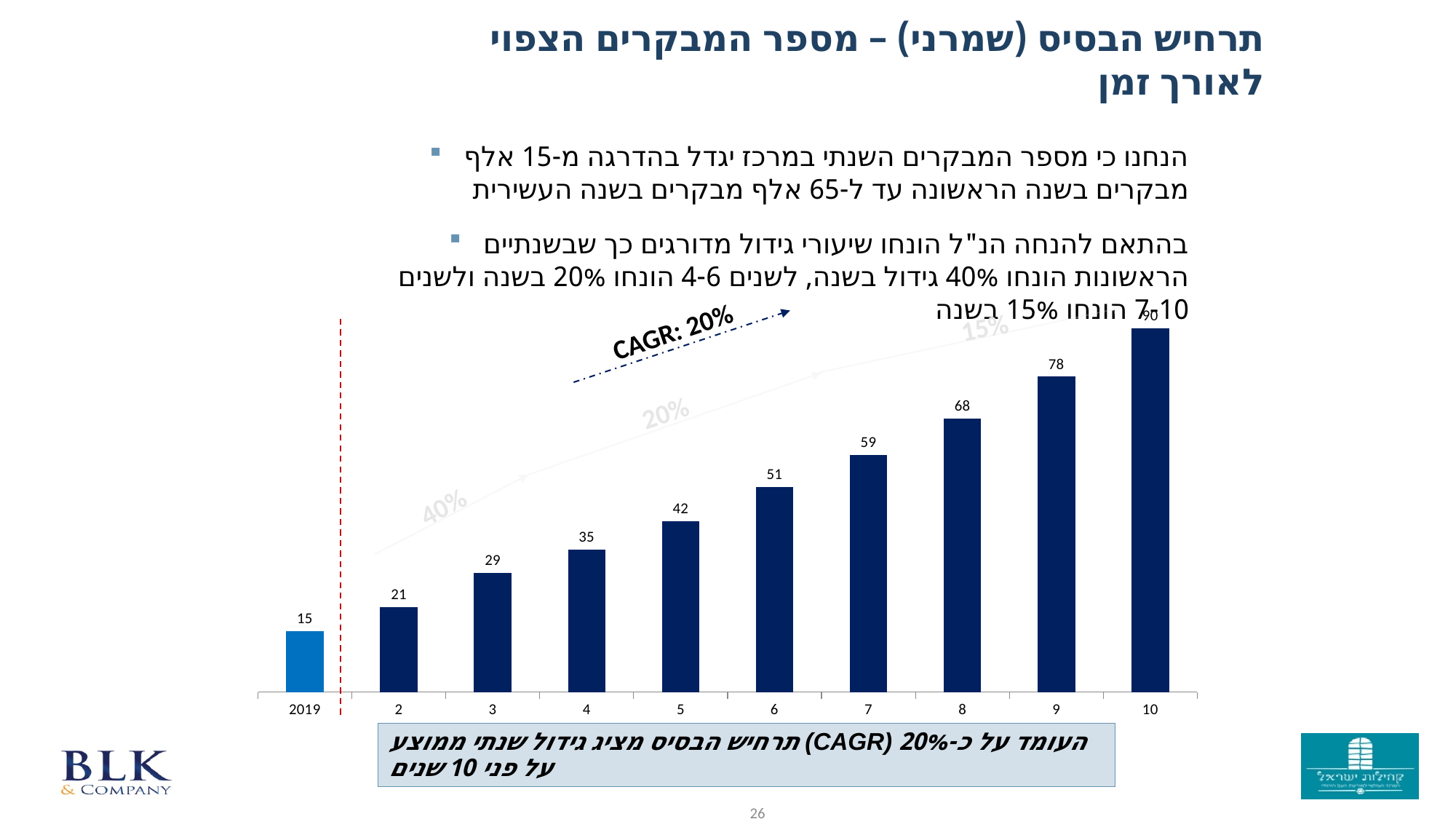
Which category has the highest value? 10 How many categories are shown on the x axis? 10 What is the difference between the value for year 9 and the value for year 2? 57 What is the value for year 9? 78 What CAGR is stated in the annotation above the bars? 20% Which is larger, the value for year 6 or the value for year 4? Year 6 What is the value for year 8? 68 Do the values rise or fall from 2019 to year 10? Rise Which category has the lowest value? 2019 What is the value for year 5? 42 What is the value for 2019? 15 What kind of chart is shown on the slide? Bar chart